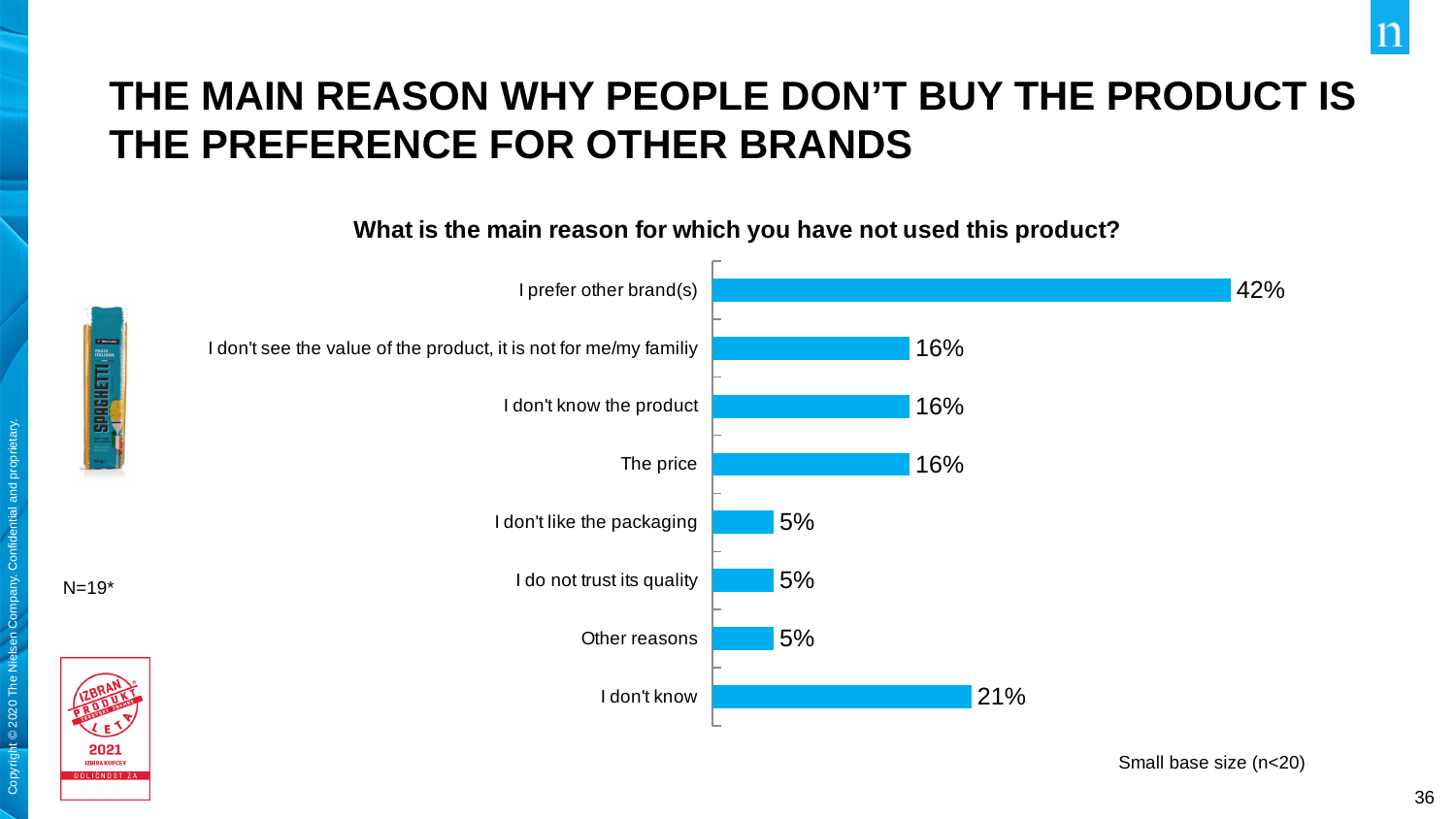
What kind of chart is shown on the slide? Bar chart What percentage of respondents said they prefer other brand(s)? 42% What is the difference between 'I prefer other brand(s)' and 'I don't know'? 21% What is the value for 'I don't like the packaging'? 5% Which reason has the highest value? I prefer other brand(s) How many reasons (categories) are shown in the chart? 8 What is the value for 'The price'? 16% What question is the chart based on, as shown in its title? What is the main reason for which you have not used this product? How many categories have a value of 5%? 3 What is the value for 'I don't know'? 21% What is the difference between 'I don't know the product' and 'Other reasons'? 11% Which is larger, the value for 'I don't know' or the value for 'The price'? I don't know